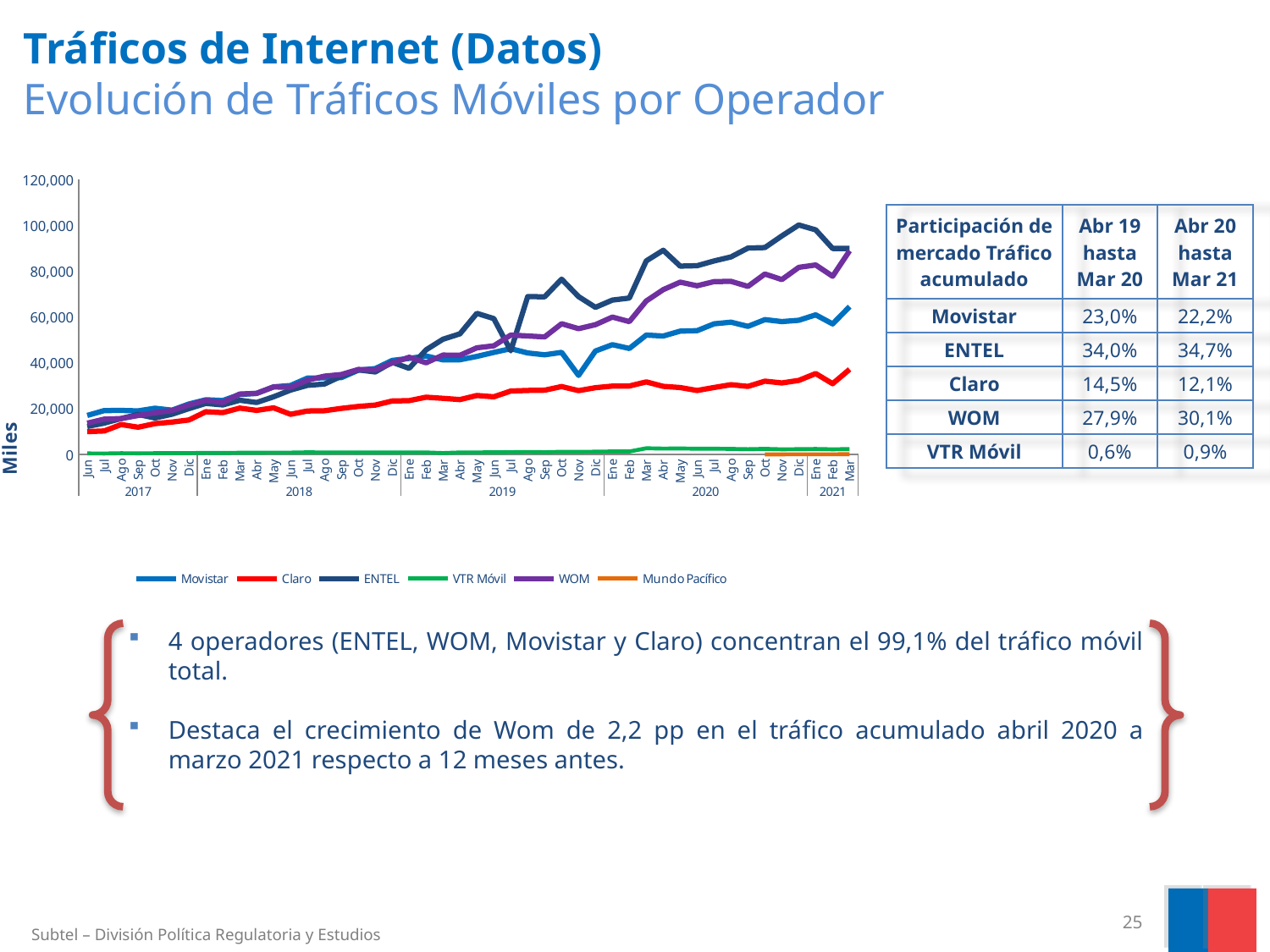
Is the value for VTR Móvil in Mar 2021 greater or less than 20,000? less In Mar 2021, which is larger, the value for Movistar or the value for Claro? Movistar How many series does the chart legend list? 6 Is the value for Movistar in Mar 2021 greater or less than 60,000? greater What colour is the Claro line in the chart? red Is the value for Claro in Mar 2021 greater or less than 40,000? less Does the Claro series generally rise or fall from Jun 2017 to Mar 2021? rise What kind of chart is shown on the slide? line chart Which series has the highest value in Nov 2020? ENTEL What is the label on the vertical axis of the chart? Miles